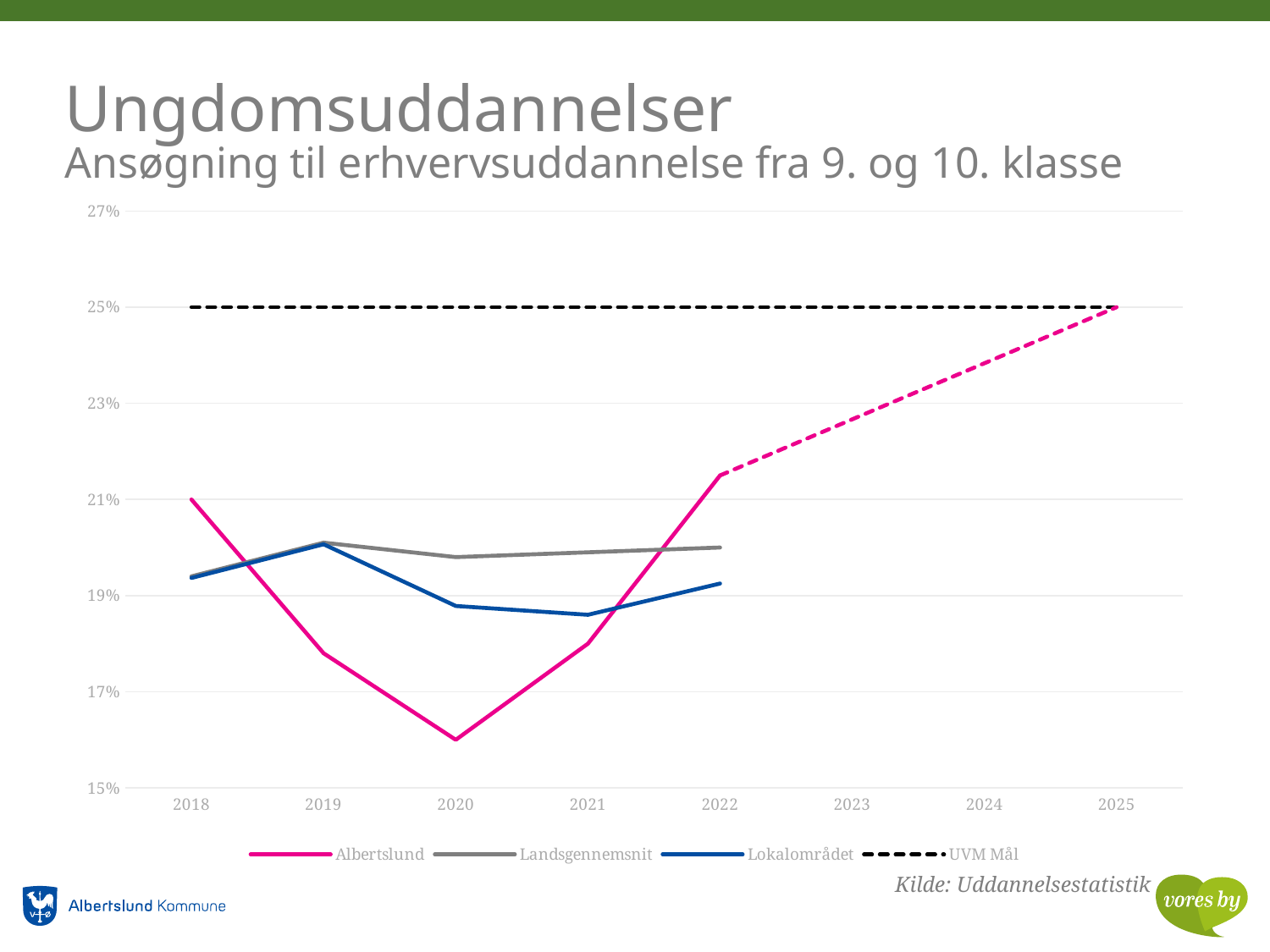
Is the value for Landsgennemsnit in 2019 greater or less than 19%? greater Is the value for Albertslund in 2022 greater or less than 21%? greater What value does the UVM Mål line sit at? 25% In 2020, which is larger: Albertslund or Landsgennemsnit? Landsgennemsnit In 2022, which is larger: Albertslund or Lokalområdet? Albertslund Is the value for Albertslund in 2020 greater or less than 17%? less In which year is the Albertslund line at its lowest? 2020 What kind of chart is shown on the slide? line chart How many years are shown on the x axis? 8 How many series does the legend list? 4 Does the Albertslund line rise or fall from 2020 to 2022? rise What source is cited below the chart? Kilde: Uddannelsesstatistik